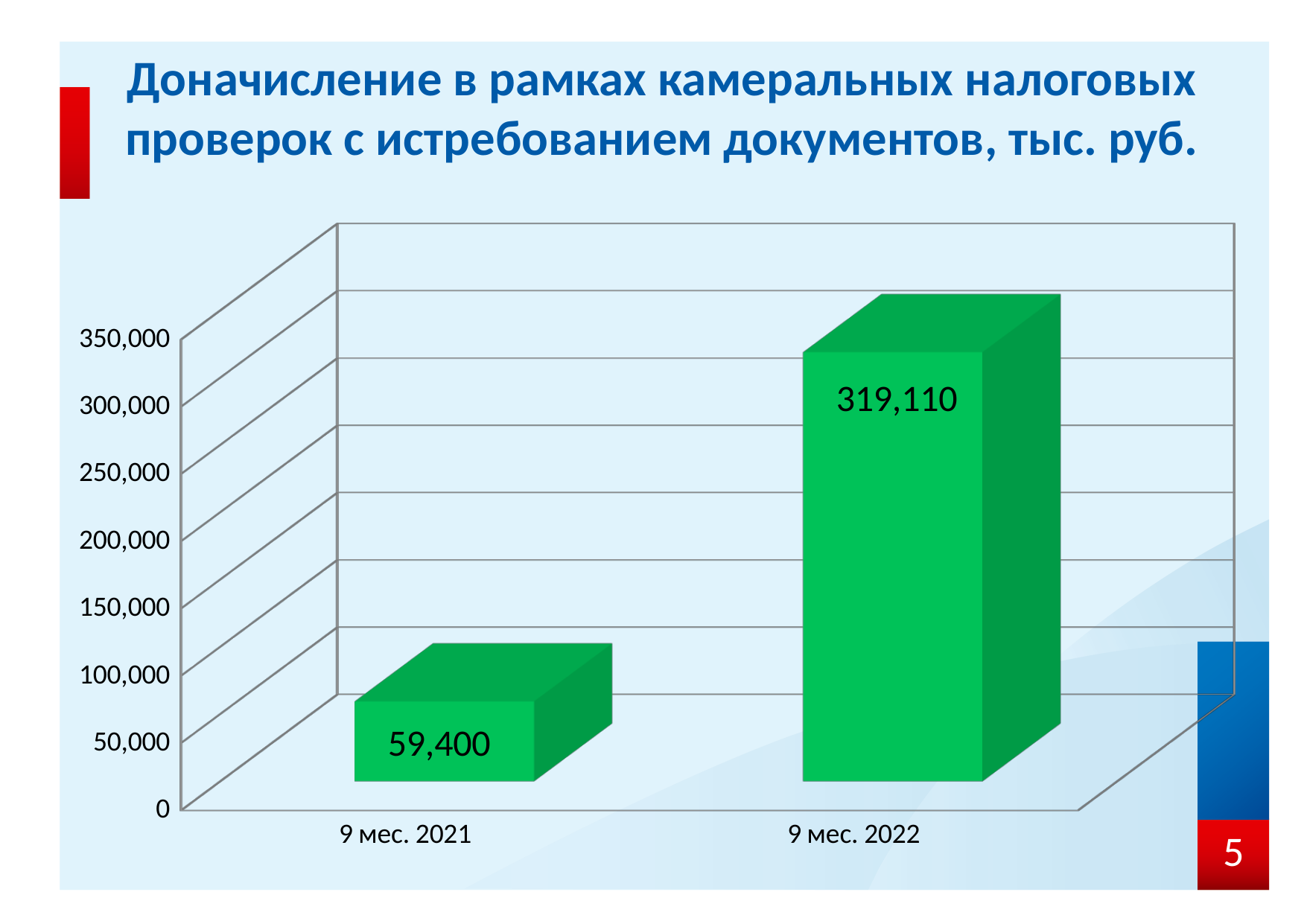
Is the value for 9 мес. 2022 greater or less than 300,000? greater What is the title of the chart? Доначисление в рамках камеральных налоговых проверок с истребованием документов, тыс. руб. Which is larger, the value for 9 мес. 2021 or the value for 9 мес. 2022? 9 мес. 2022 Which category has the highest value? 9 мес. 2022 How many categories are shown on the x axis? 2 Is the value for 9 мес. 2021 greater or less than 100,000? less What is the value for 9 мес. 2021? 59,400 Do the values rise or fall from 9 мес. 2021 to 9 мес. 2022? rise What is the difference between the values for 9 мес. 2022 and 9 мес. 2021? 259,710 What is the value for 9 мес. 2022? 319,110 What kind of chart is shown on the slide? bar chart Which category has the lowest value? 9 мес. 2021